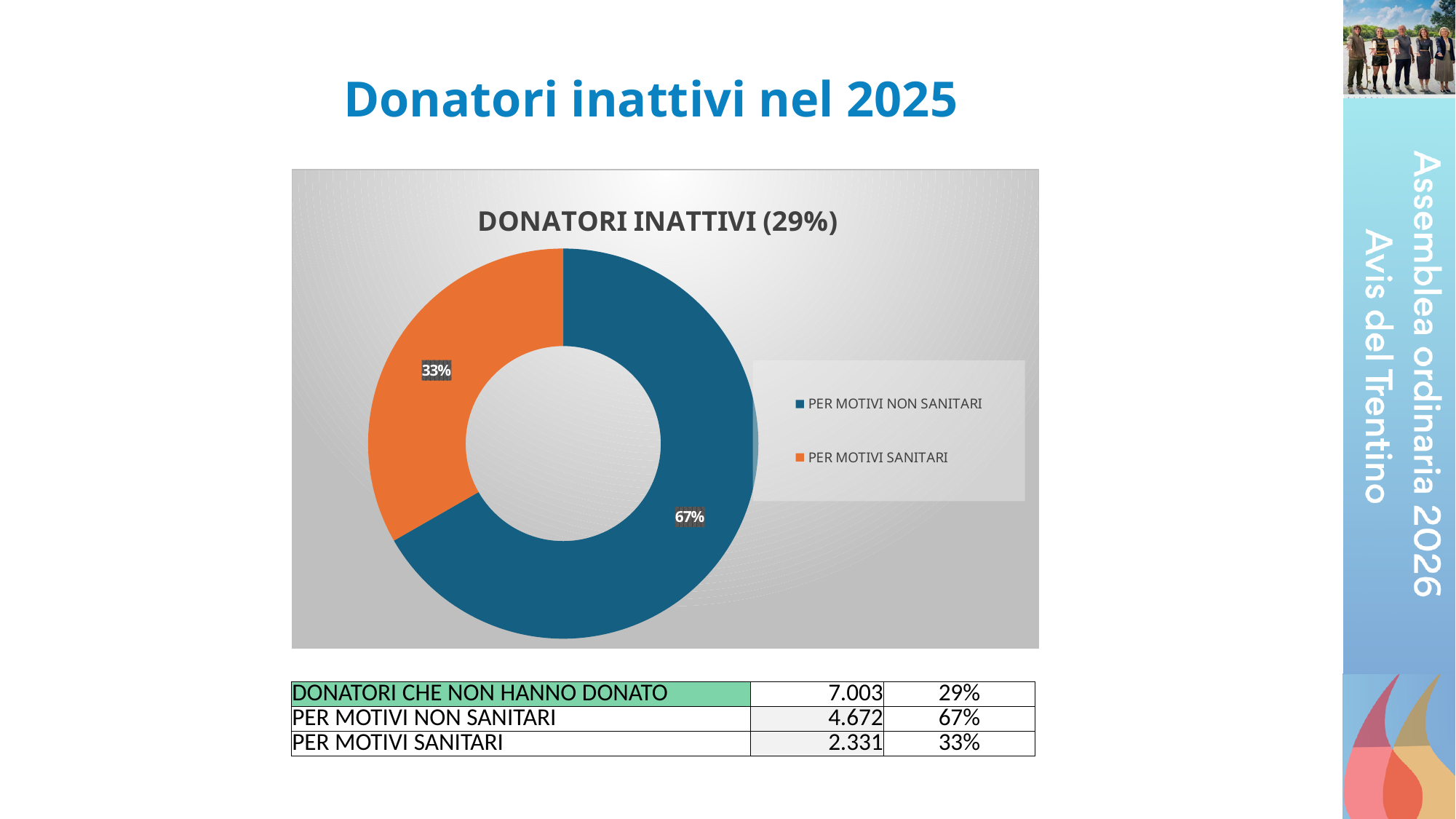
How many slices does the pie chart have? 2 Is the share for PER MOTIVI SANITARI greater or less than 50%? less What is the title of the chart? DONATORI INATTIVI (29%) Which category has the smallest slice of the pie? PER MOTIVI SANITARI Which is larger, the slice for PER MOTIVI NON SANITARI or the slice for PER MOTIVI SANITARI? PER MOTIVI NON SANITARI What kind of chart is shown on the slide? Pie chart (doughnut) Which category has the largest slice of the pie? PER MOTIVI NON SANITARI What share of the pie does PER MOTIVI NON SANITARI represent? 67% What share of the pie does PER MOTIVI SANITARI represent? 33% What colour is the slice for PER MOTIVI SANITARI? Orange How many entries does the legend list? 2 What is the difference in percentage points between the PER MOTIVI NON SANITARI slice and the PER MOTIVI SANITARI slice? 34%